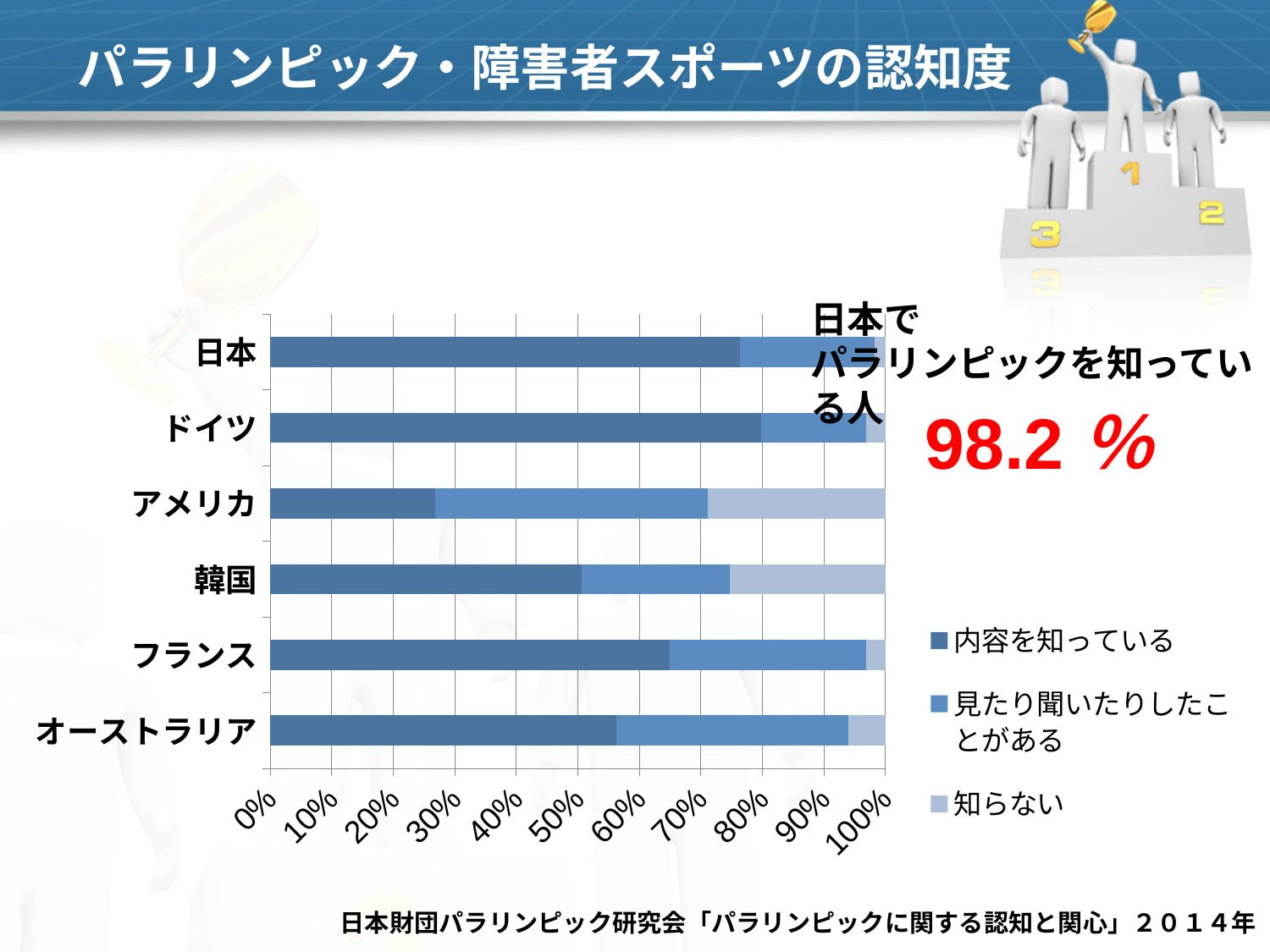
Which has a larger 内容を知っている segment, フランス or オーストラリア? フランス Is the 内容を知っている value for 日本 greater or less than 70%? greater Which country has the largest 内容を知っている segment? ドイツ Is the 内容を知っている value for フランス greater or less than 60%? greater Which country has the smallest 内容を知っている segment? アメリカ Which has a larger 内容を知っている segment, 韓国 or アメリカ? 韓国 Which country has the largest 知らない segment? アメリカ What is the title of the slide? パラリンピック・障害者スポーツの認知度 Is the 内容を知っている value for アメリカ greater or less than 30%? less What kind of chart is shown on the slide? Stacked bar chart How many series does the legend list? 3 How many countries are plotted on the chart? 6